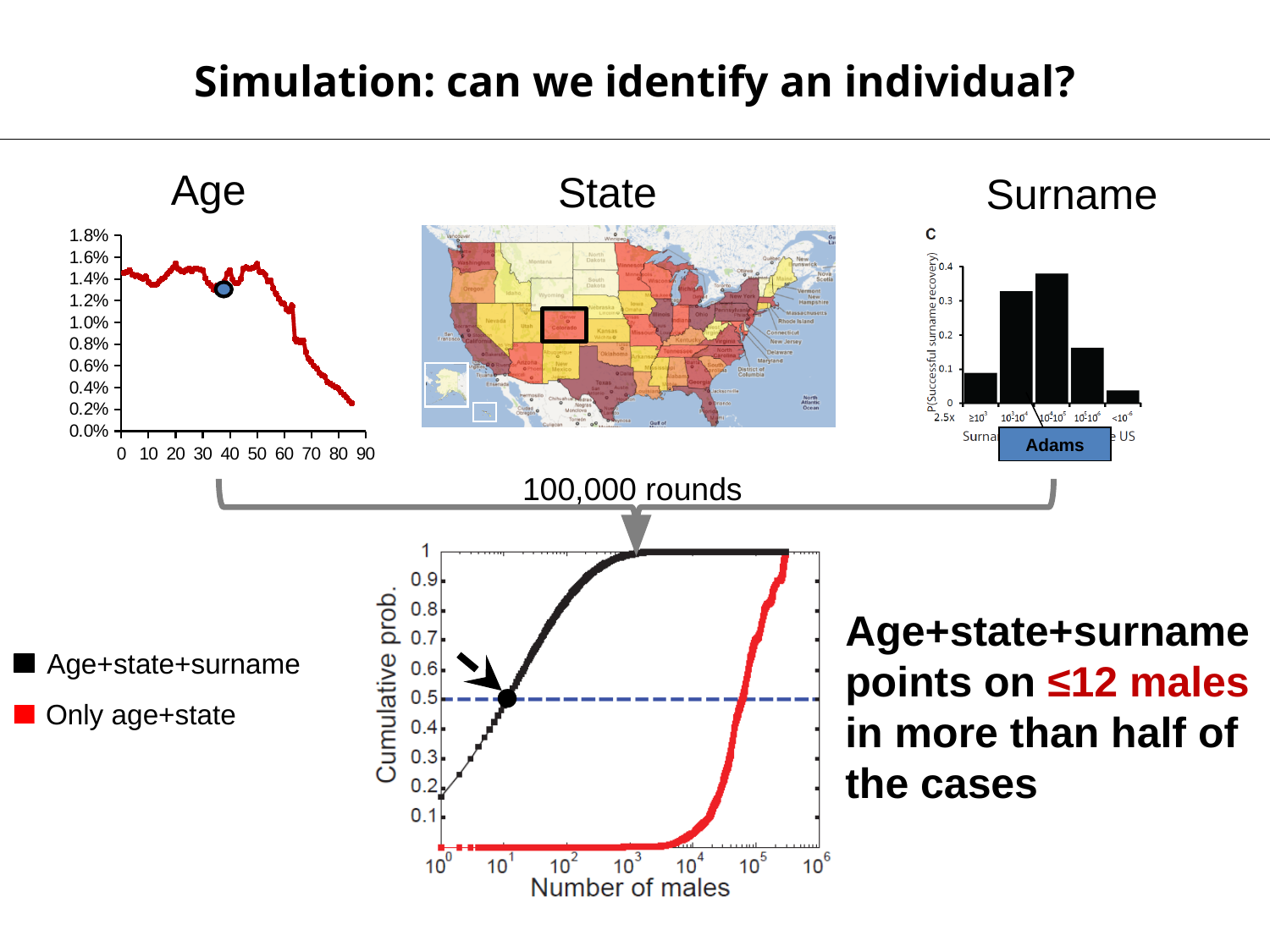
In the Age chart, is the value at age 20 greater or less than 1.2%? greater In the Age chart, do the values rise or fall between age 60 and age 90? fall In the bottom cumulative probability chart, which series reaches a cumulative probability of 0.5 at a smaller number of males, Age+state+surname or Only age+state? Age+state+surname How many bars does the Surname chart show? 5 How many series does the legend of the bottom cumulative probability chart list? 2 What kind of chart is the Surname chart on the right of the slide? bar chart What kind of chart is the Age chart on the left of the slide? line chart In the Surname chart, is the first bar (≥10^3) greater or less than 0.1? less In the bottom cumulative probability chart, do the values of the Age+state+surname series rise or fall as the number of males increases? rise What is the x-axis label of the bottom cumulative probability chart? Number of males In the Surname chart, is the tallest bar greater or less than 0.3? greater